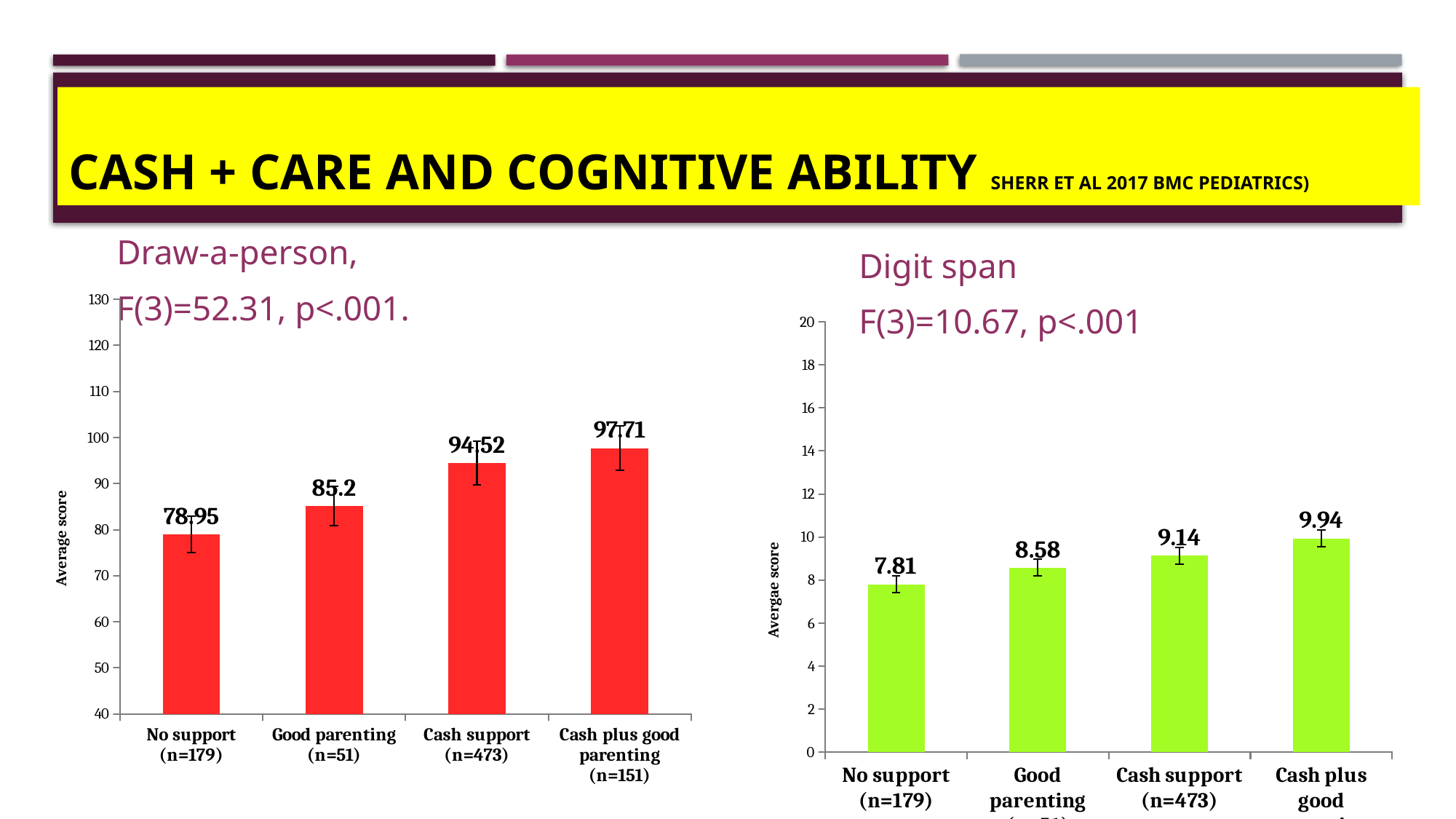
What type of chart is the Digit span chart? bar chart What colour are the bars in the Draw-a-person chart? red In the Digit span chart, what is the average score for the No support group? 7.81 In the Draw-a-person chart, which is larger: the score for Good parenting or the score for Cash support? Cash support How many groups are shown in the Draw-a-person chart? 4 In the Digit span chart, do the average scores rise or fall from No support to Cash plus good parenting? rise In the Digit span chart, which group has the lowest average score? No support In the Digit span chart, what is the difference between the Cash plus good parenting score and the No support score? 2.13 In the Draw-a-person chart, what is the average score for the Cash support group? 94.52 In the Draw-a-person chart, which group has the highest average score? Cash plus good parenting In the Digit span chart, is the value for Good parenting greater or less than 10? less In the Draw-a-person chart, what is the difference between the Cash plus good parenting score and the No support score? 18.76